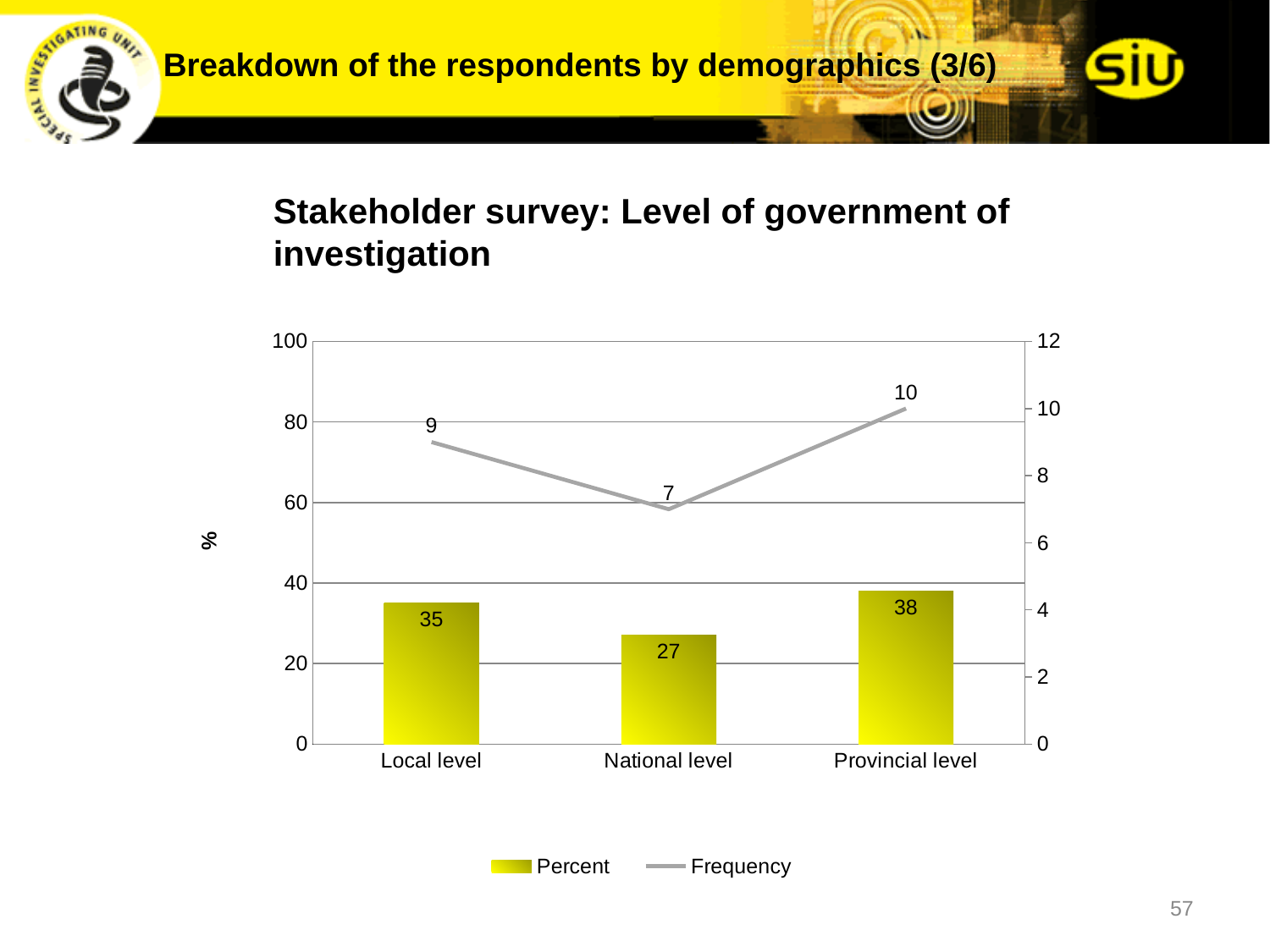
What is the difference between the Percent values for Provincial level and National level? 11 Which level has the lowest Frequency value? National level How many levels of government are shown on the x axis? 3 What is the Frequency value for Provincial level? 10 Which is larger, the Frequency for Local level or the Frequency for National level? Local level Is the Percent value for Provincial level greater or less than 40? less What kind of chart is used to show the Percent series? Bar chart How many series does the legend list? 2 What is the title of the chart? Stakeholder survey: Level of government of investigation What is the Percent value for Local level? 35 What is the Percent value for National level? 27 Which level has the highest Percent value? Provincial level